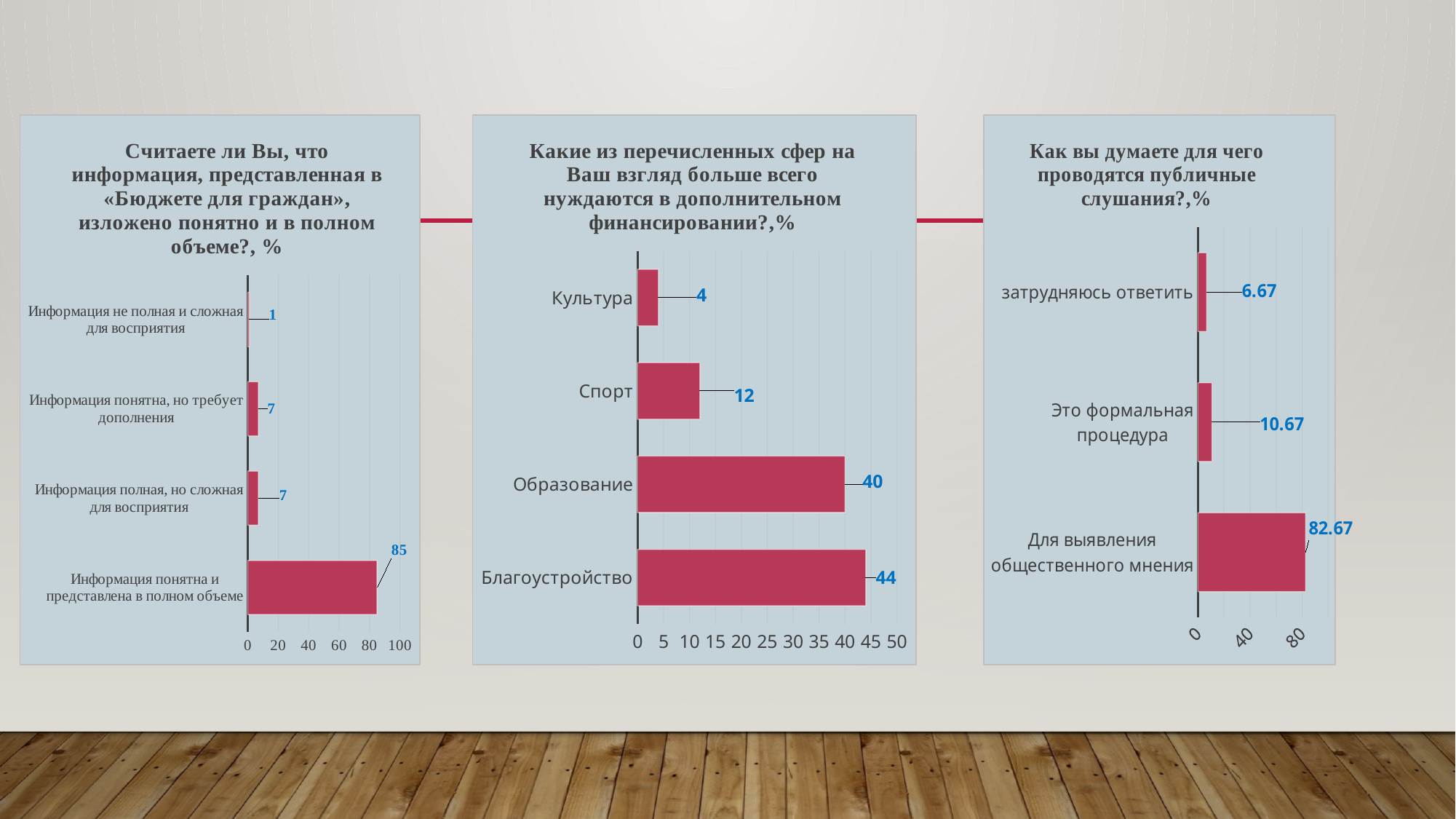
In the right chart, what is the difference between "Это формальная процедура" and "затрудняюсь ответить"? 4 In the middle chart, which category has the highest value? Благоустройство In the left chart, what is the difference between "Информация понятна и представлена в полном объеме" and "Информация понятна, но требует дополнения"? 78 What kind of chart is the middle chart? Bar chart In the middle chart ("Какие из перечисленных сфер на Ваш взгляд больше всего нуждаются в дополнительном финансировании?,%"), what is the value for Образование? 40 In the right chart ("Как вы думаете для чего проводятся публичные слушания?,%"), what is the value for "Это формальная процедура"? 10.67 In the left chart ("Считаете ли Вы, что информация, представленная в «Бюджете для граждан», изложено понятно и в полном объеме?, %"), what is the value for "Информация понятна и представлена в полном объеме"? 85 In the left chart, which category has the lowest value? Информация не полная и сложная для восприятия In the right chart, which category has the highest value? Для выявления общественного мнения In the middle chart, which is larger: Спорт or Культура? Спорт In the middle chart, what is the difference between Благоустройство and Образование? 4 How many categories does the left chart show? 4